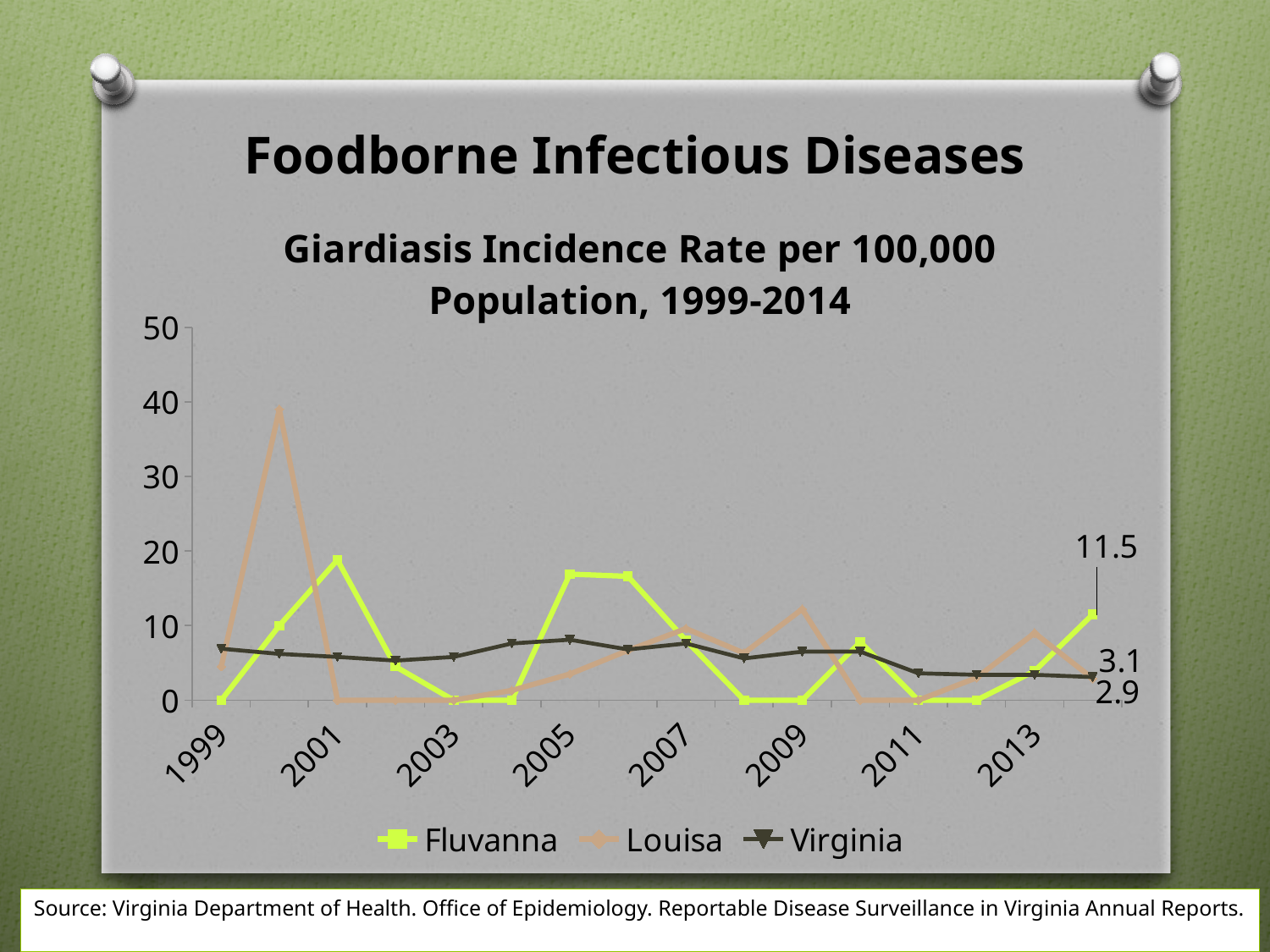
Which series reaches the highest value anywhere on the chart? Louisa Is the value for Fluvanna in 2005 greater or less than 10? greater Which is larger in 2001, the Fluvanna value or the Louisa value? Fluvanna Does the Virginia series rise or fall from 2010 to 2014? fall Is the value for Louisa in 2000 greater or less than 30? greater Which series are listed in the legend? Fluvanna, Louisa, Virginia How many series does the legend list? 3 In which year does the Louisa series reach its highest value? 2000 What is the title of the chart? Giardiasis Incidence Rate per 100,000 Population, 1999-2014 Is the value for Virginia in 1999 greater or less than 10? less What is the Fluvanna incidence rate in 2014? 11.5 What kind of chart is shown on the slide? line chart